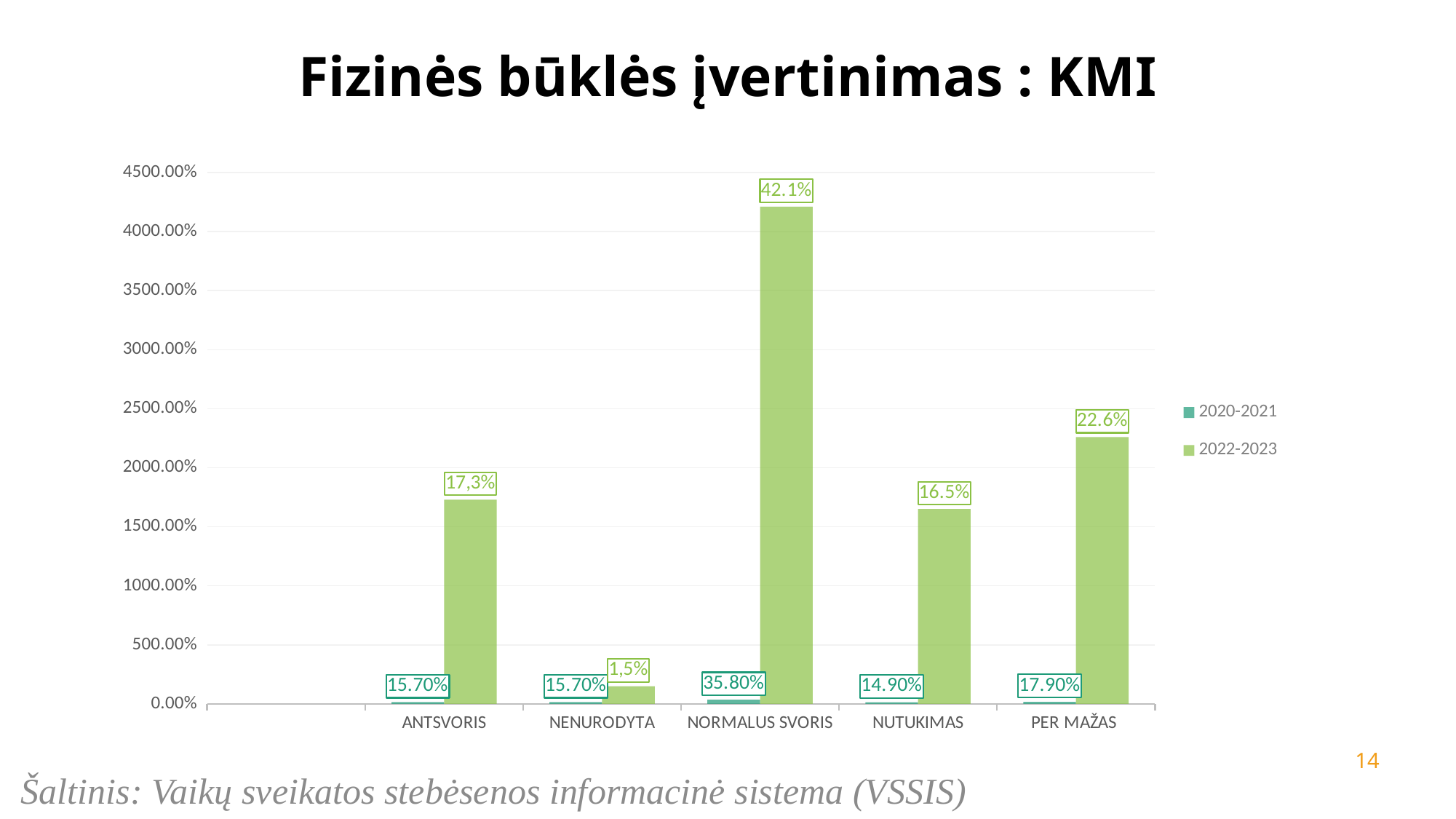
What is the 2022-2023 value for ANTSVORIS? 17,3% Which category has the highest 2020-2021 value? NORMALUS SVORIS What is the 2020-2021 value for NUTUKIMAS? 14.90% For 2022-2023, which is larger: PER MAŽAS or NUTUKIMAS? PER MAŽAS How many series does the legend list? 2 Which category has the lowest 2022-2023 value? NENURODYTA How many categories are shown on the x axis? 5 Which category has the highest 2022-2023 value? NORMALUS SVORIS What is the difference between the 2020-2021 values for NORMALUS SVORIS and ANTSVORIS? 20.10% What is the 2022-2023 value for NORMALUS SVORIS? 42.1% What is the 2020-2021 value for PER MAŽAS? 17.90% What type of chart is shown on the slide? Bar chart